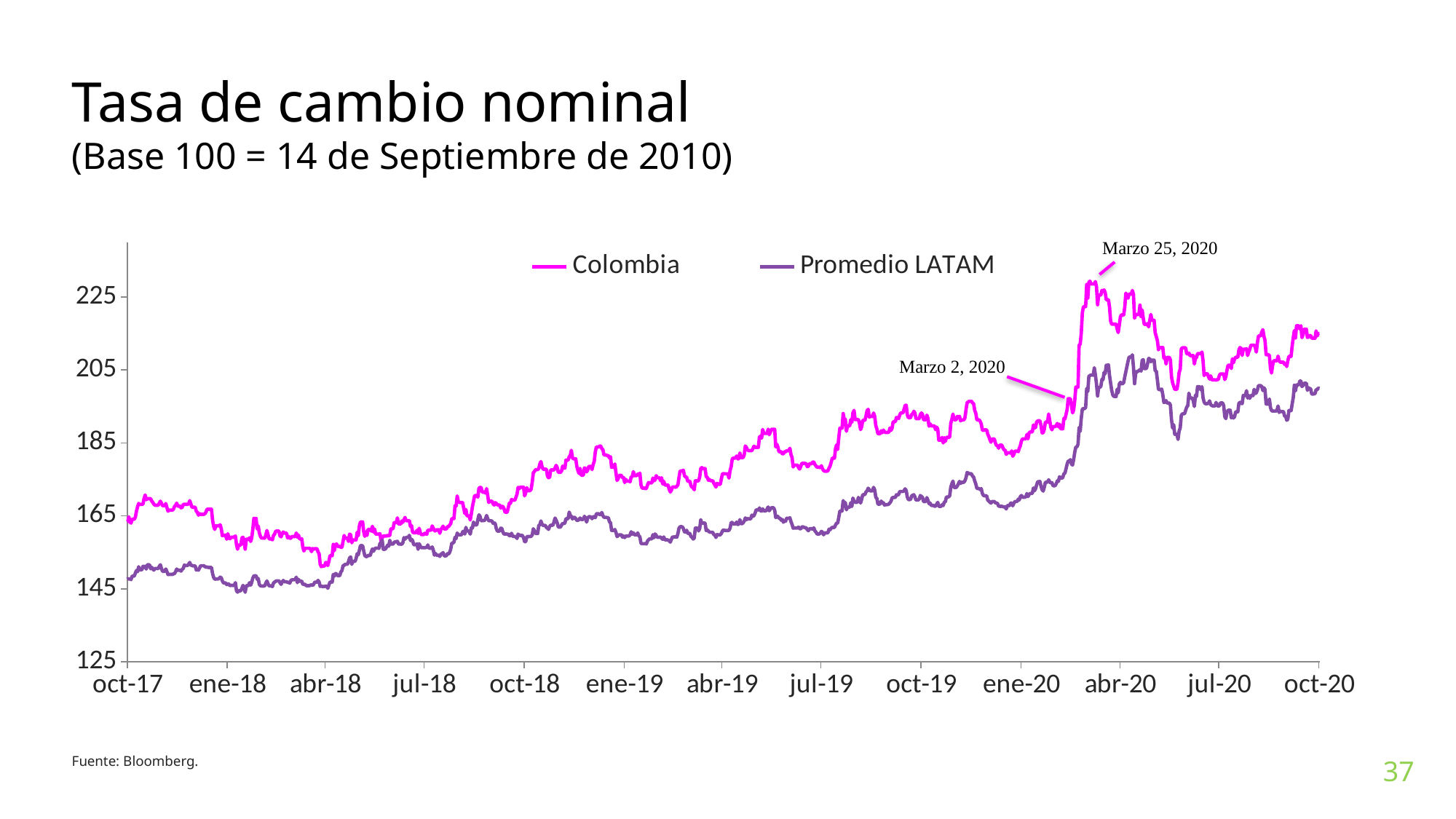
Which series is higher at oct-20, Colombia or Promedio LATAM? Colombia Is the value for Promedio LATAM at oct-20 greater or less than 205? less Is the value for Colombia at jul-19 greater or less than 165? greater Which series reaches the highest point on the chart? Colombia What is the title of the chart on the slide? Tasa de cambio nominal Is the value for Promedio LATAM at jul-19 greater or less than 165? less Do the values for Colombia generally rise or fall from oct-17 to oct-20? rise What kind of chart is shown on the slide? line chart What are the two series named in the legend? Colombia and Promedio LATAM How many series does the legend list? 2